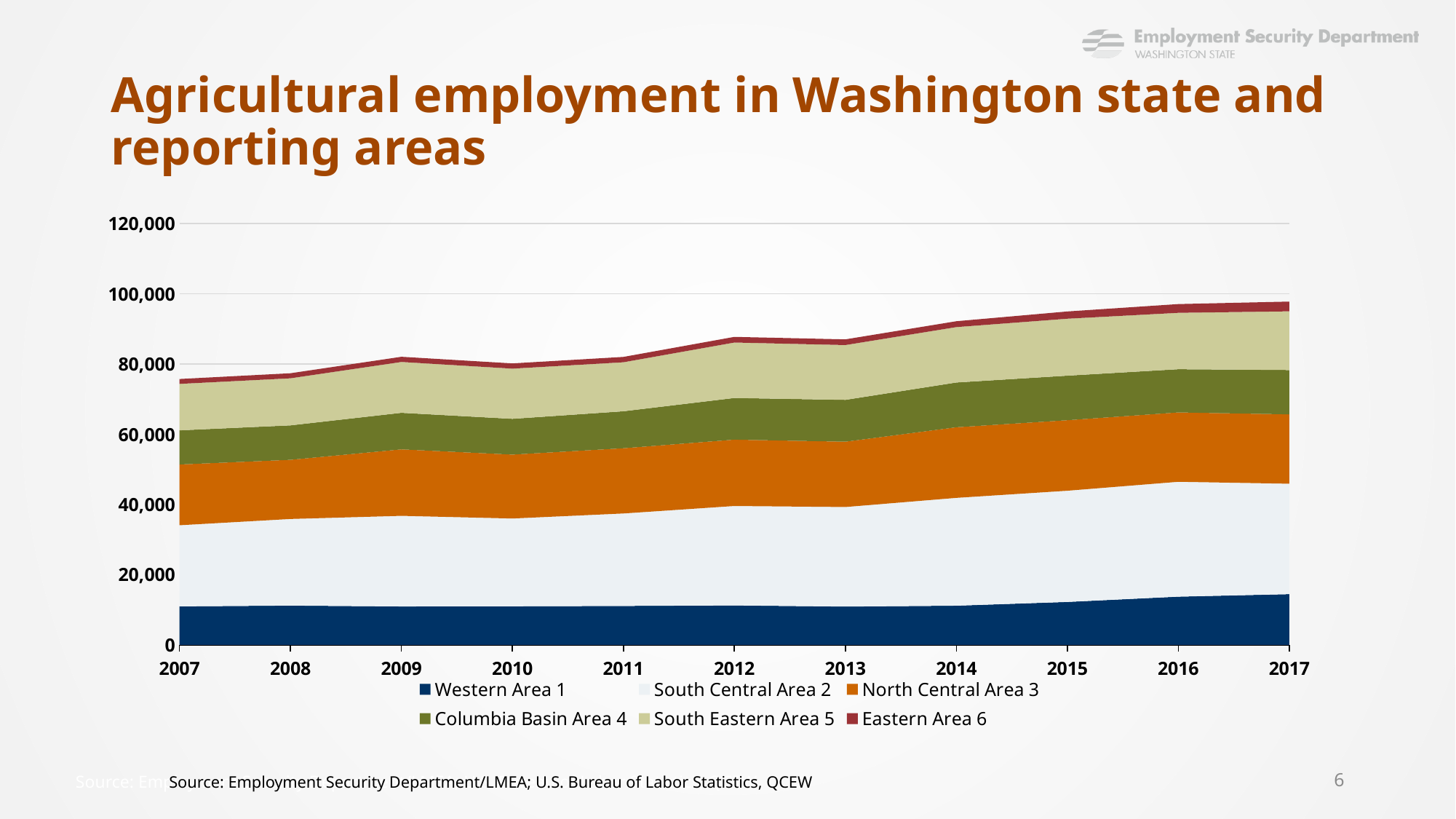
What kind of chart is shown on the slide? Stacked area chart Is the value for Western Area 1 in 2007 greater or less than 20,000? less Which year has the highest total agricultural employment? 2017 How many series does the legend list? 6 Is the total stacked value for 2012 greater or less than 80,000? greater Is the total stacked value for 2017 greater or less than 100,000? less Which is larger, the total agricultural employment in 2017 or in 2007? 2017 Does total agricultural employment generally rise or fall from 2007 to 2017? Rise How many years are shown along the x axis? 11 Which series is shown at the bottom of the stack in dark blue? Western Area 1 Which year has the lowest total agricultural employment? 2007